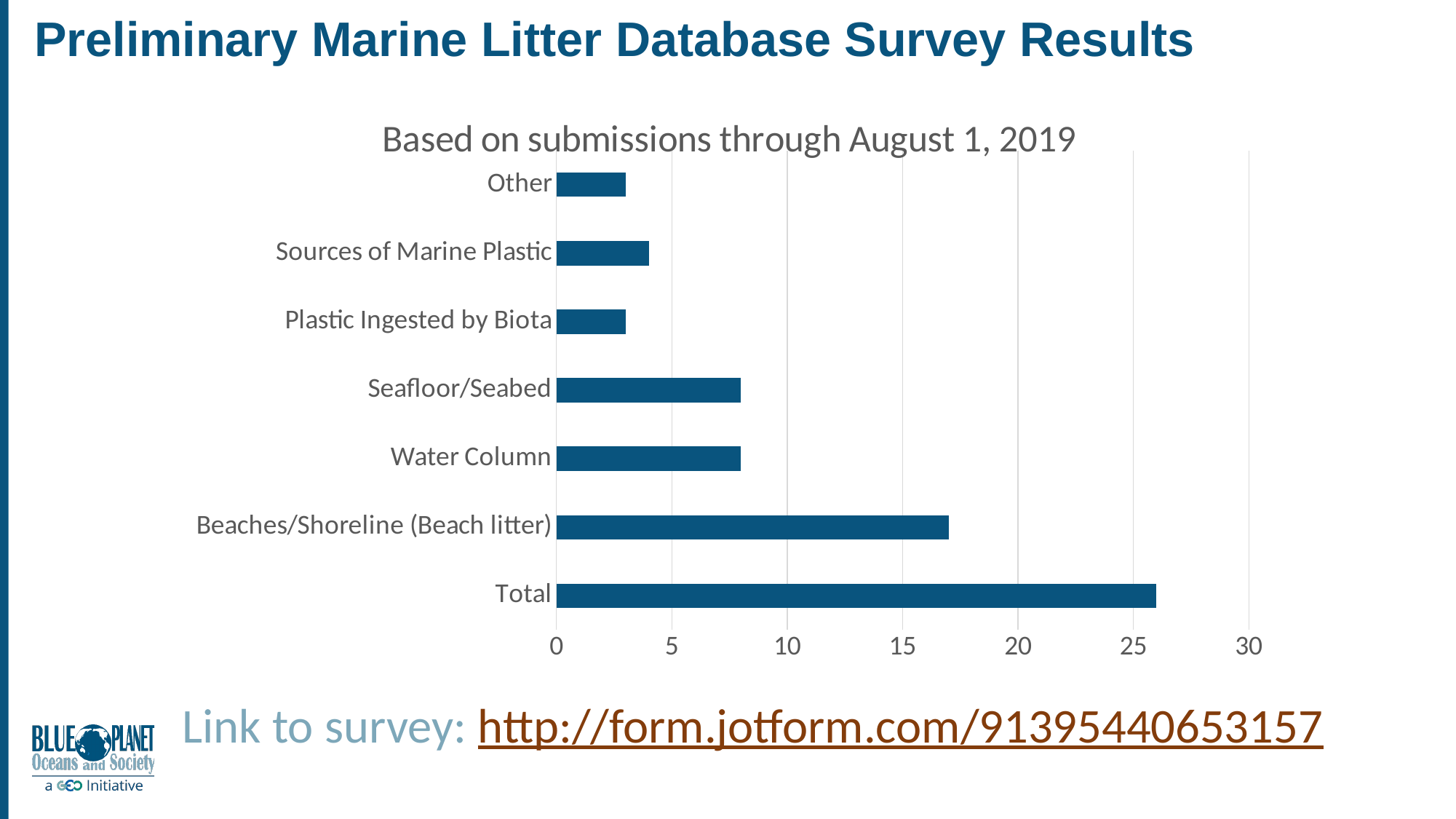
What is the highest value shown on the horizontal axis? 30 Is the value for Beaches/Shoreline (Beach litter) greater or less than 20? less Is the value for Beaches/Shoreline (Beach litter) greater or less than 15? greater Which is larger, the value for Beaches/Shoreline (Beach litter) or the value for Water Column? Beaches/Shoreline (Beach litter) Which category has the longest bar? Total Is the value for Total greater or less than 25? greater What is the title of the chart? Based on submissions through August 1, 2019 What kind of chart is shown on the slide? bar chart Which is larger, the value for Seafloor/Seabed or the value for Other? Seafloor/Seabed How many categories are plotted in the chart? 7